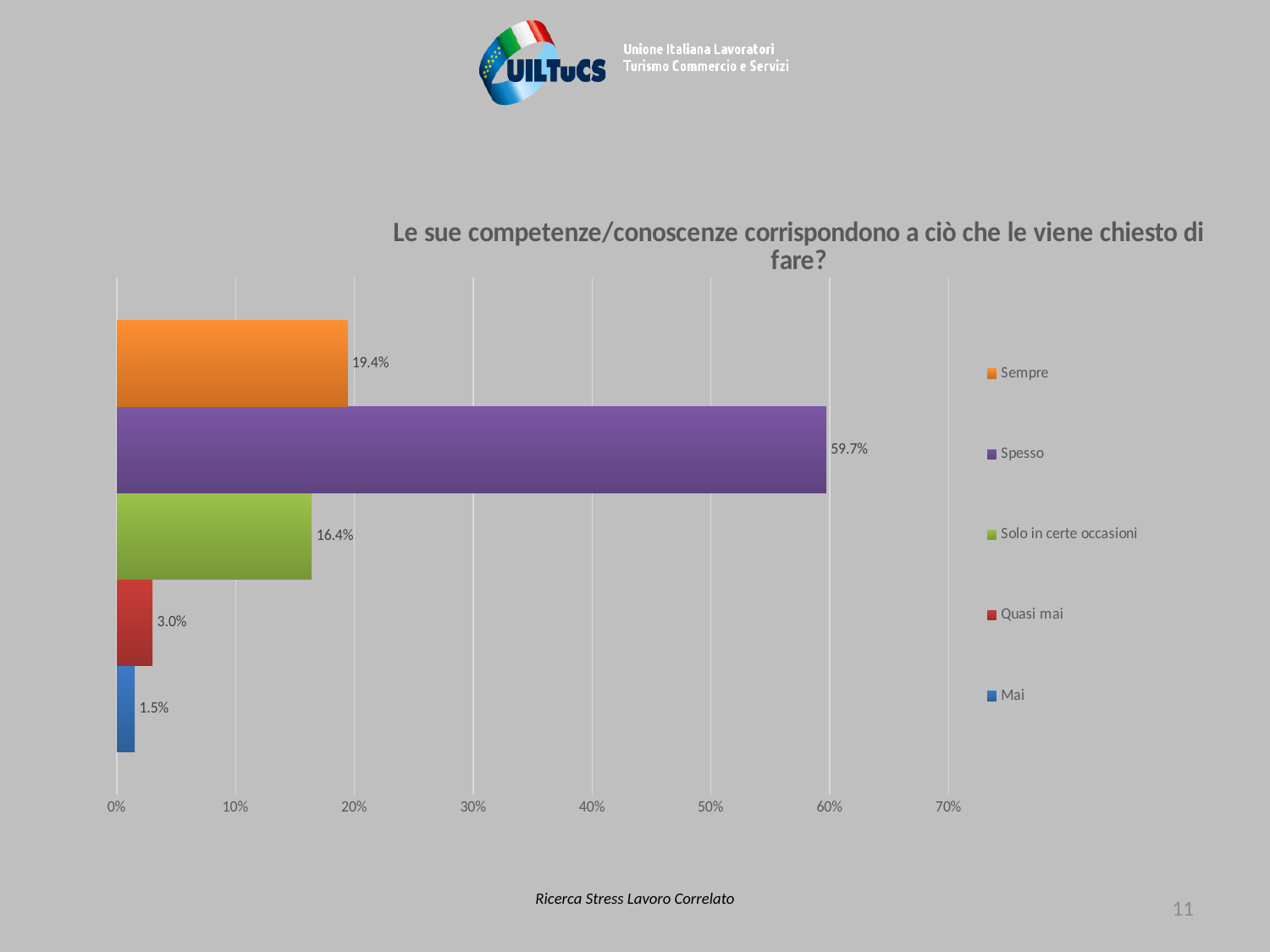
What is the value for Quasi mai? 3.0% What is the value for Solo in certe occasioni? 16.4% Which is larger, the value for Sempre or the value for Solo in certe occasioni? Sempre What kind of chart is shown on the slide? Bar chart Which category has the lowest value? Mai Which category has the highest value? Spesso How many categories does the legend list? 5 What is the value for Spesso? 59.7% What is the difference between the values for Spesso and Sempre? 40.3% What is the value for Mai? 1.5% What is the title of the chart? Le sue competenze/conoscenze corrispondono a ciò che le viene chiesto di fare? What is the value for Sempre? 19.4%